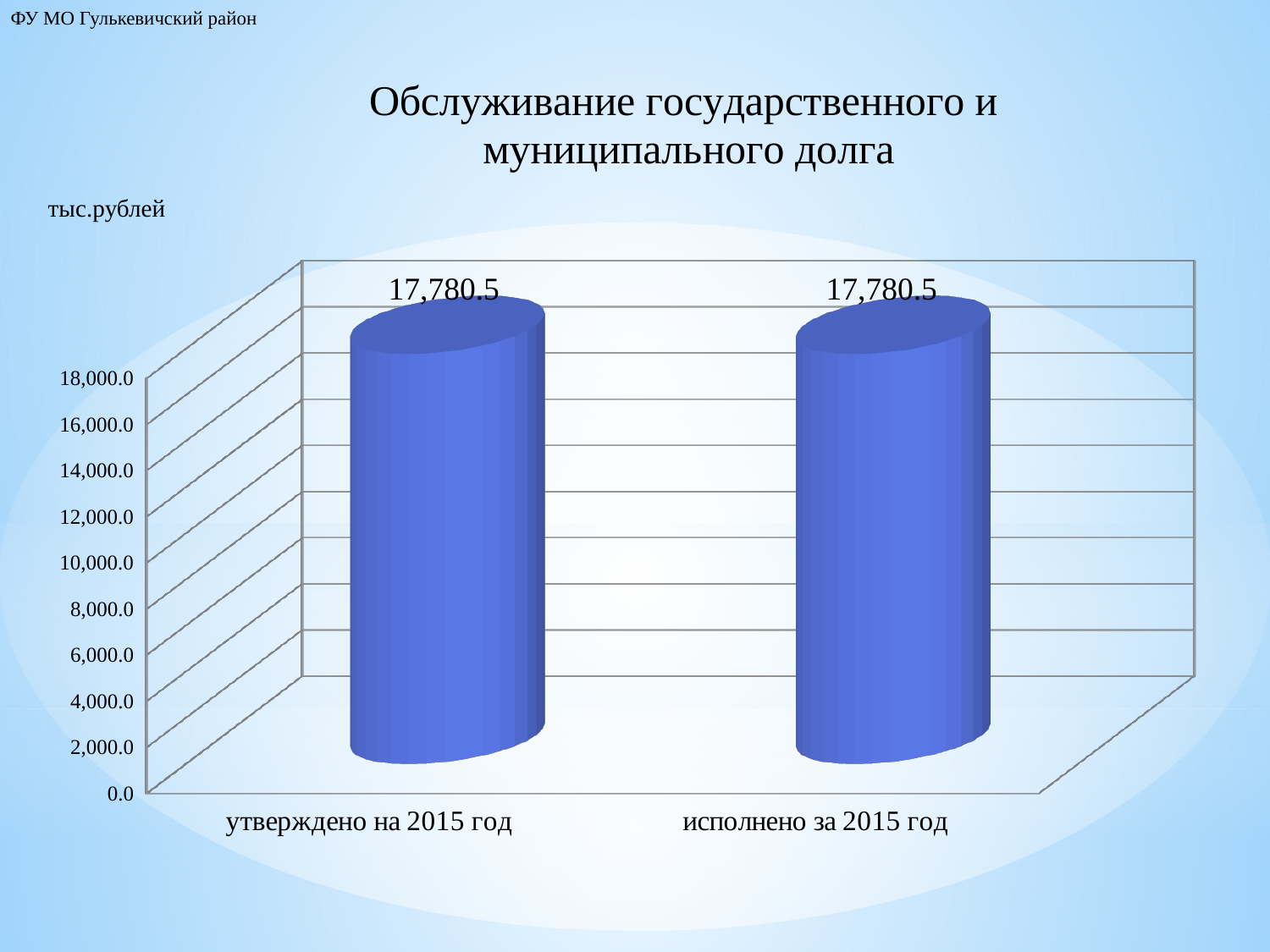
What is the title of the chart? Обслуживание государственного и муниципального долга What is the difference between the values for "утверждено на 2015 год" and "исполнено за 2015 год"? 0.0 What is the highest value shown on the vertical axis? 18,000.0 Do the values rise, fall or stay the same from "утверждено на 2015 год" to "исполнено за 2015 год"? Stay the same What unit is indicated for the values in the chart? тыс.рублей What is the value for "утверждено на 2015 год"? 17,780.5 Is the value for "исполнено за 2015 год" greater or less than 16,000.0? greater How many categories are shown on the x axis of the chart? 2 What is the value for "исполнено за 2015 год"? 17,780.5 What kind of chart is shown on the slide? Bar chart Is the value for "утверждено на 2015 год" greater or less than 18,000.0? less